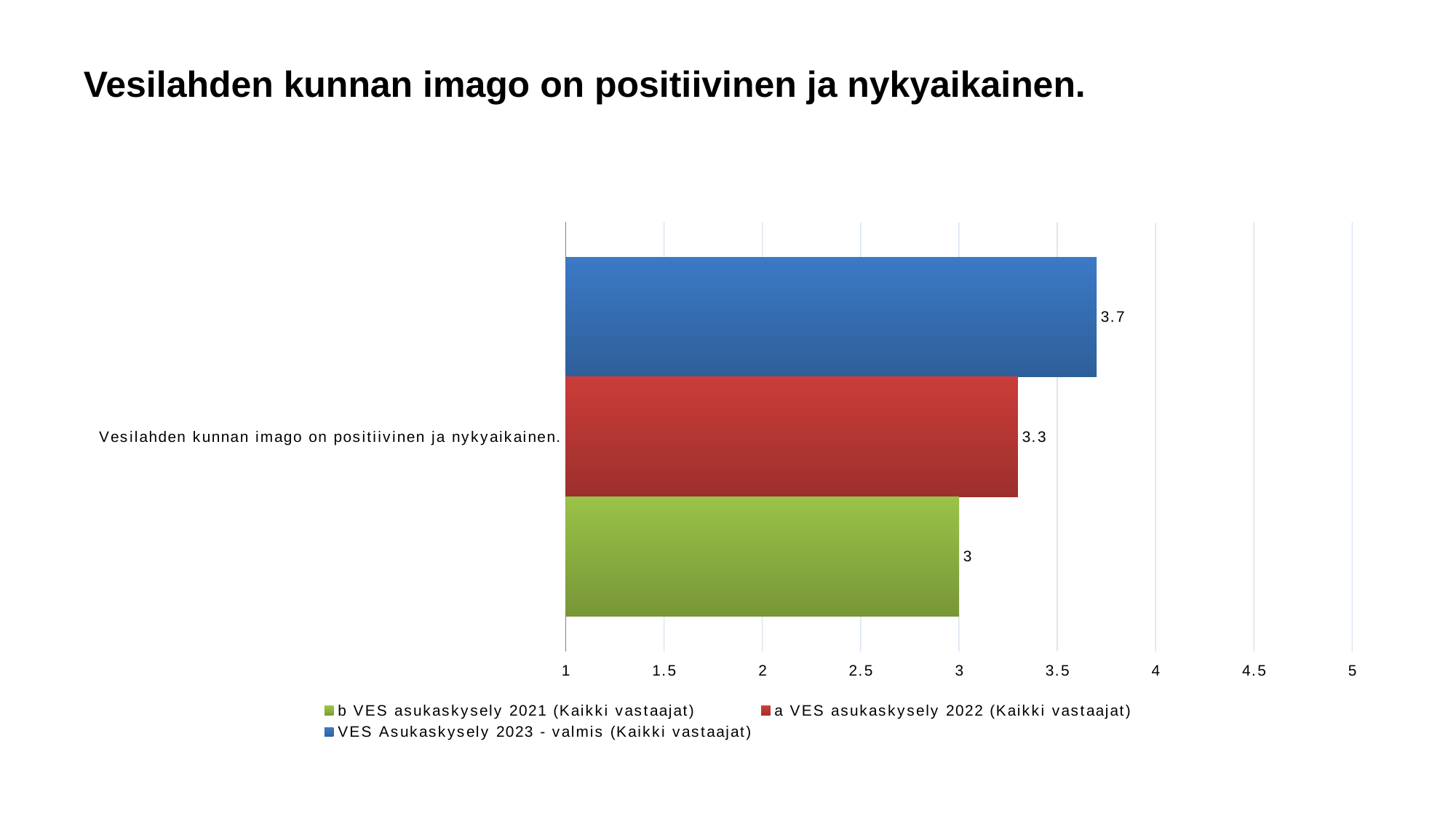
What is the difference between the 2023 value and the 2022 value? 0.4 How many series does the legend list? 3 What is the difference between the 2023 value and the 2021 value? 0.7 What is the value for the 2021 survey (b VES asukaskysely 2021) series? 3 What is the value for the 2022 survey (a VES asukaskysely 2022) series? 3.3 What kind of chart is shown on the slide? bar chart What colour is the bar for the 2022 survey series? red What is the value for the 2023 survey (VES Asukaskysely 2023 - valmis) series? 3.7 Which survey year has the highest value? VES Asukaskysely 2023 - valmis (Kaikki vastaajat) Which is larger, the 2022 value or the 2021 value? 2022 Is the value for the 2023 survey greater or less than 3.5? greater Which survey year has the lowest value? b VES asukaskysely 2021 (Kaikki vastaajat)